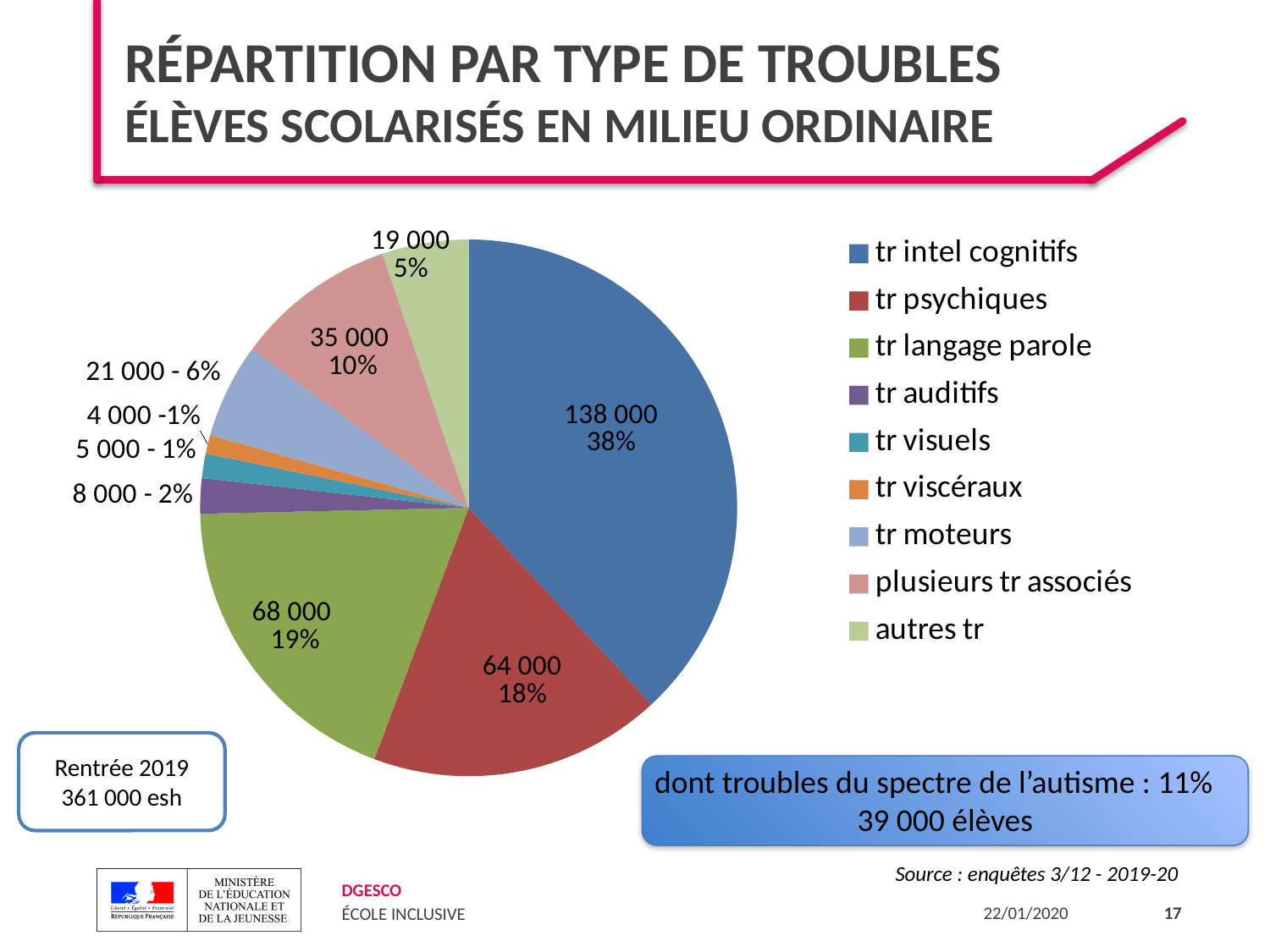
What is the value shown for 'plusieurs tr associés'? 35 000 What is the value shown for 'tr intel cognitifs'? 138 000 Which category has the largest slice of the pie? tr intel cognitifs How many categories does the legend of the pie chart list? 9 What is the value shown for 'autres tr'? 19 000 What percentage is shown for 'tr psychiques'? 18% What is the value shown for 'tr langage parole'? 68 000 What share of the pie does 'tr intel cognitifs' represent? 38% Which is larger, 'tr langage parole' or 'tr psychiques'? tr langage parole What percentage is shown for 'tr moteurs'? 6% What type of chart is shown on the slide? pie chart What is the difference between the values for 'tr intel cognitifs' and 'tr psychiques'? 74 000